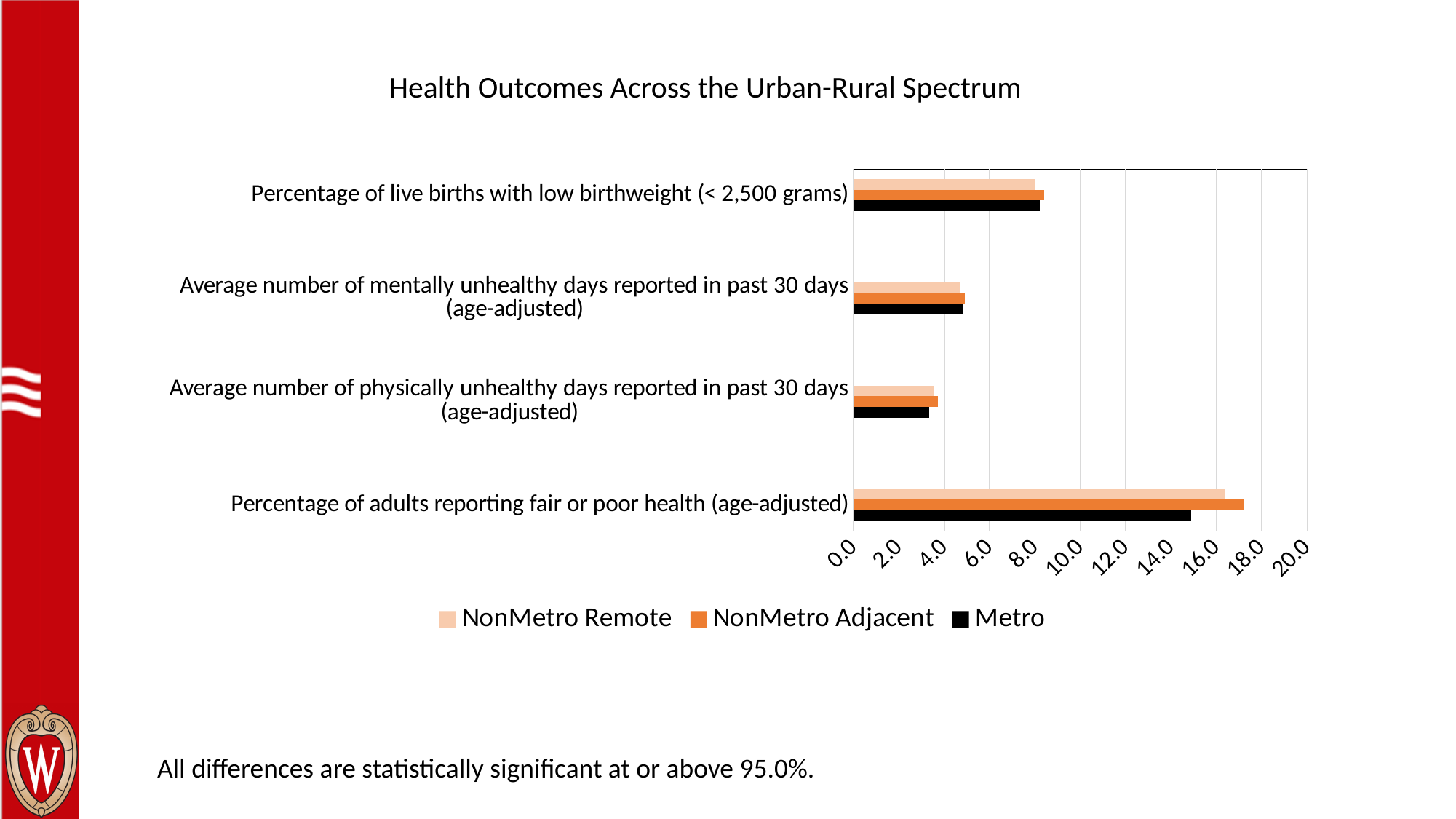
How many series does the legend list? 3 Which category has the lowest values across all three series? Average number of physically unhealthy days reported in past 30 days (age-adjusted) For the average number of physically unhealthy days, which is larger: NonMetro Adjacent or Metro? NonMetro Adjacent What is the title of the chart? Health Outcomes Across the Urban-Rural Spectrum What kind of chart is shown on the slide? bar chart Is the NonMetro Adjacent value for percentage of adults reporting fair or poor health greater or less than 16.0? greater Is the Metro value for percentage of adults reporting fair or poor health greater or less than 16.0? less Which colour represents the Metro series in the chart? black How many health outcome categories are plotted on the chart? 4 Which category has the highest values across all three series? Percentage of adults reporting fair or poor health (age-adjusted) For the percentage of adults reporting fair or poor health, which is larger: NonMetro Adjacent or Metro? NonMetro Adjacent Is the NonMetro Remote value for percentage of live births with low birthweight greater or less than 10.0? less